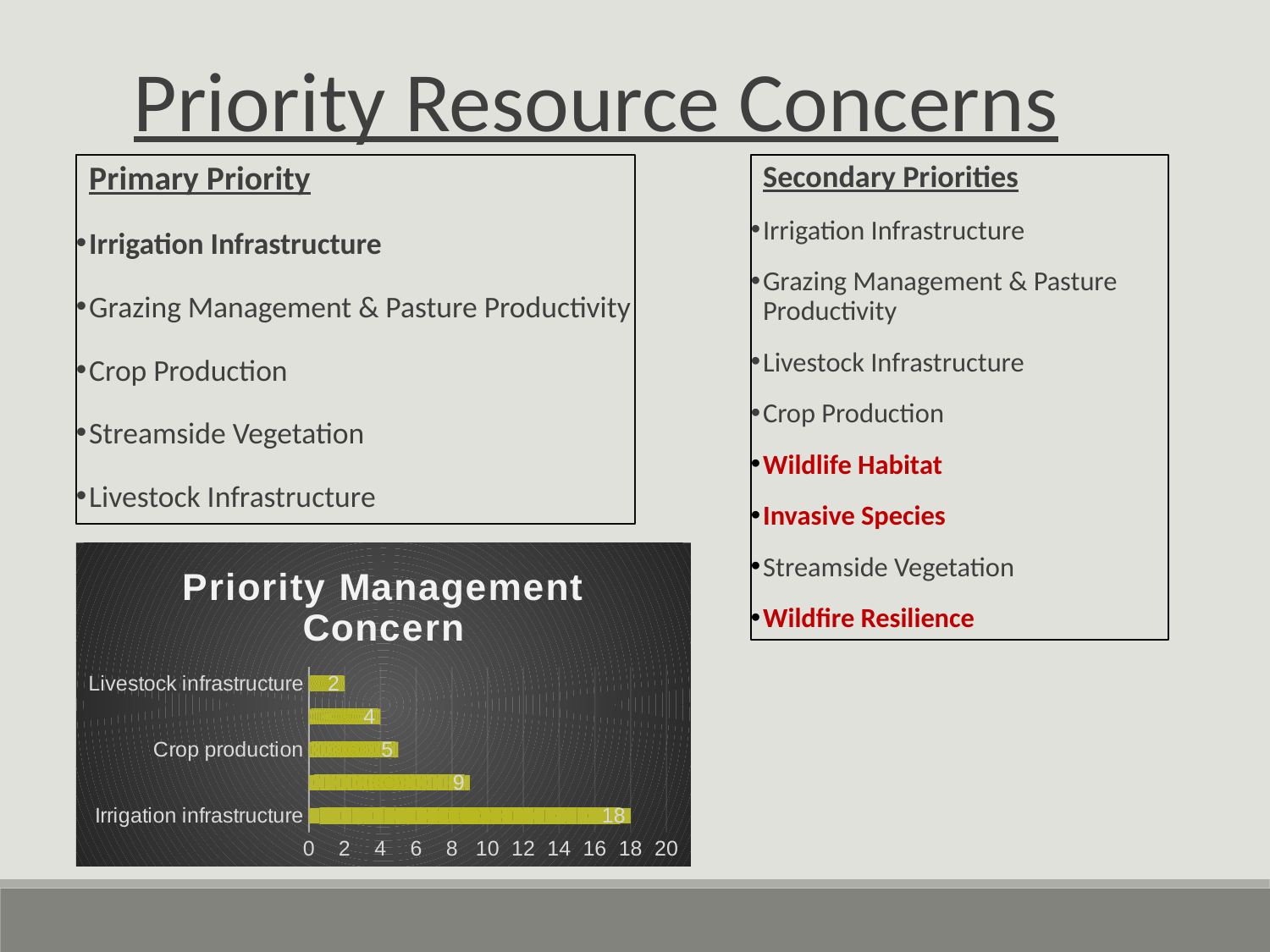
What is the value for Irrigation infrastructure in the Priority Management Concern chart? 18 Which category has the highest value in the Priority Management Concern chart? Irrigation infrastructure What is the difference between the values for Irrigation infrastructure and Crop production in the Priority Management Concern chart? 13 Which category has the lowest value in the Priority Management Concern chart? Livestock infrastructure What is the value for Crop production in the Priority Management Concern chart? 5 What is the title of the chart on the slide? Priority Management Concern Which is larger in the Priority Management Concern chart, the value for Crop production or the value for Livestock infrastructure? Crop production What is the difference between the values for Crop production and Livestock infrastructure in the Priority Management Concern chart? 3 What is the value for Livestock infrastructure in the Priority Management Concern chart? 2 How many bars are plotted in the Priority Management Concern chart? 5 What kind of chart is the Priority Management Concern chart? bar chart Is the value for Irrigation infrastructure in the Priority Management Concern chart greater or less than 10? greater